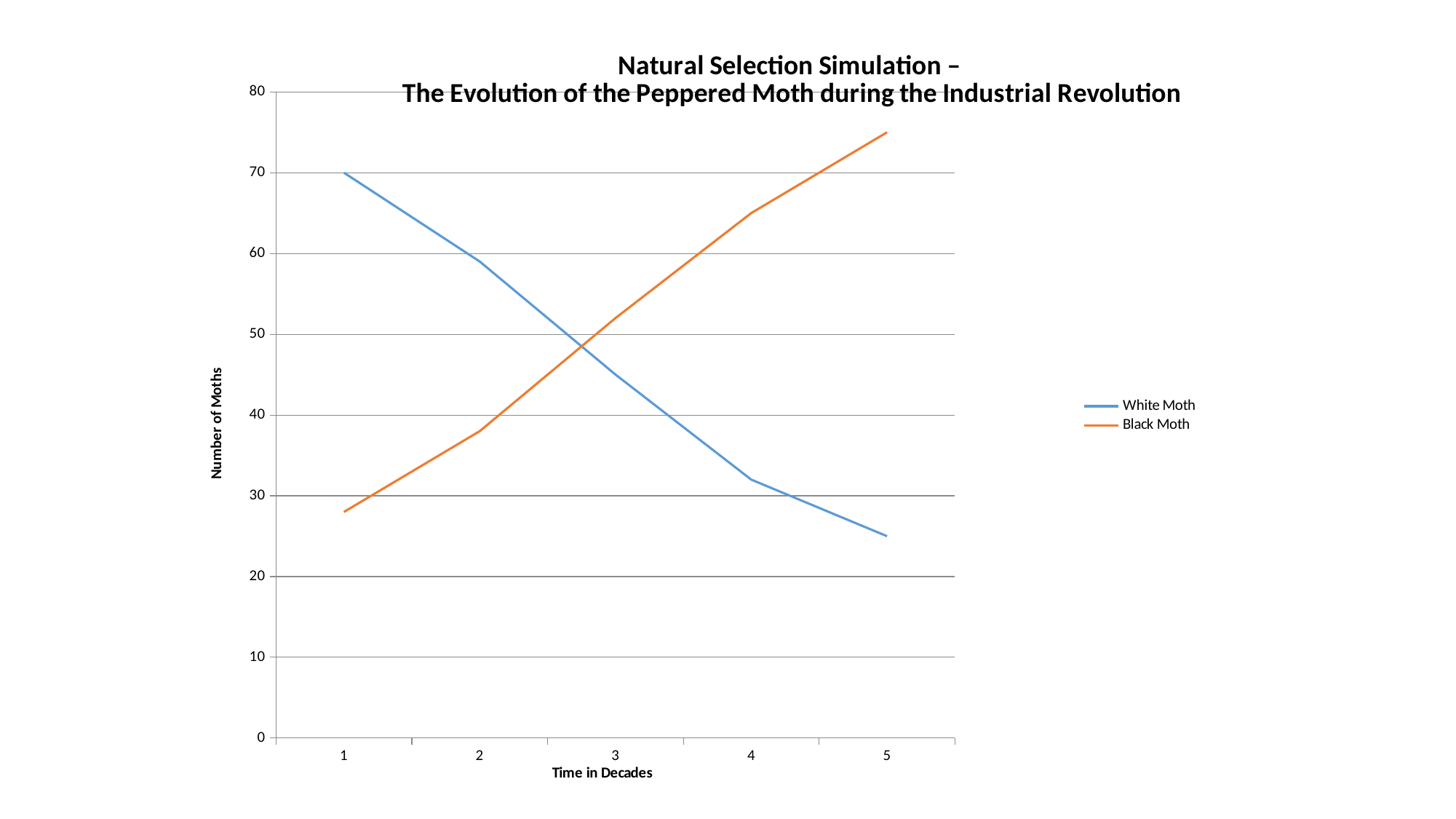
Is the value for White Moth at decade 5 greater or less than 30? less What is the title of the vertical axis? Number of Moths Is the value for Black Moth at decade 5 greater or less than 70? greater Is the value for Black Moth at decade 1 greater or less than 30? less How many series does the legend list? 2 Does the Black Moth line rise or fall from decade 1 to decade 5? rise At which decade is the White Moth value highest? 1 Does the White Moth line rise or fall from decade 1 to decade 5? fall What is the number of White Moths at decade 1? 70 What kind of chart is shown on the slide? line chart At decade 4, which series has the larger value, White Moth or Black Moth? Black Moth How many time points (decades) are plotted along the x axis? 5